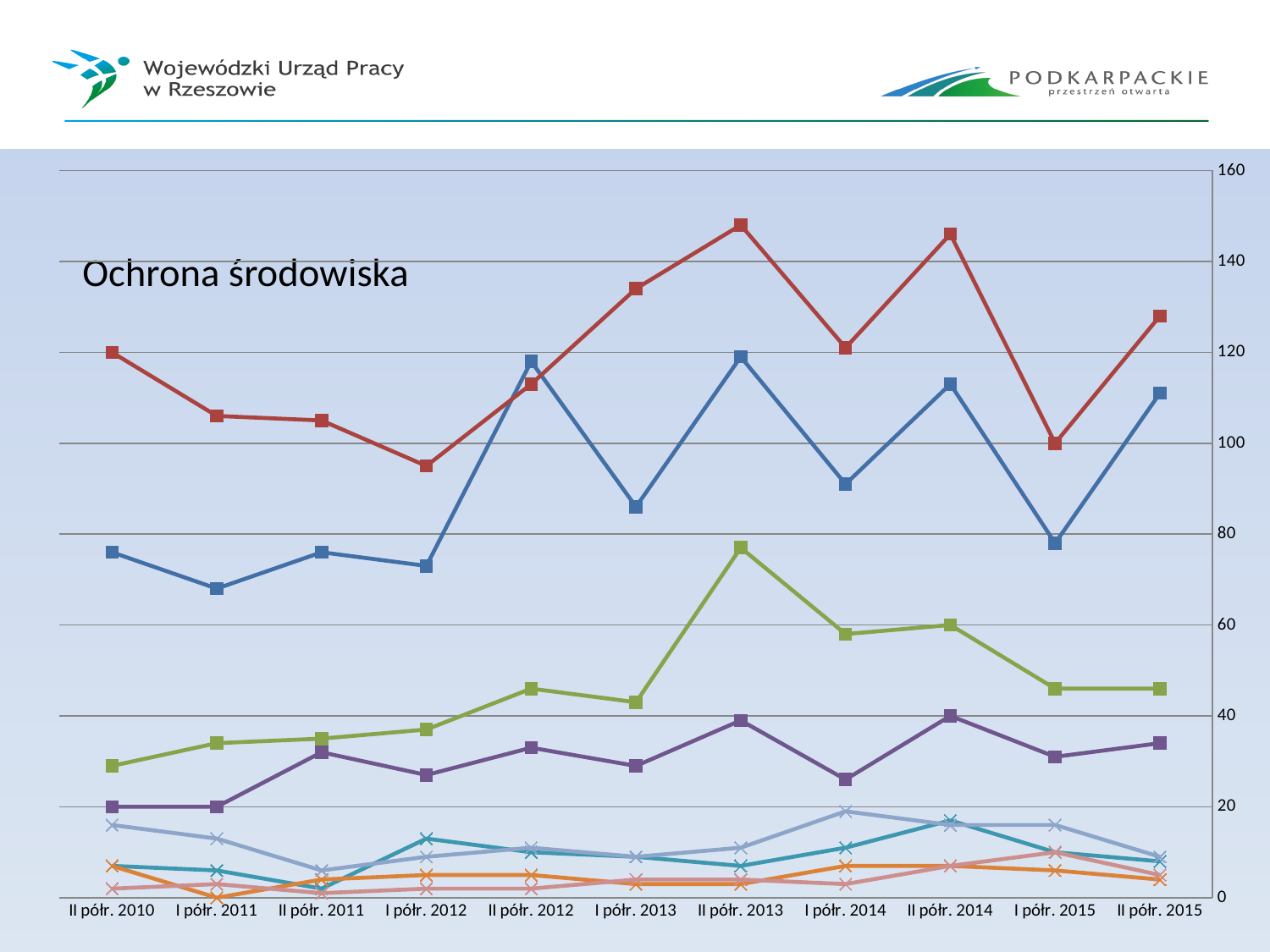
What kind of chart is shown on the slide? line chart What is the highest value shown on the y axis of the chart? 160 Is the value of the red series at I półr. 2012 greater or less than 100? less In which period does the blue series reach its lowest value? I półr. 2011 Is the value of the blue series at I półr. 2013 greater or less than 100? less In which period does the green series reach its highest value? II półr. 2013 How many periods are shown along the x axis of the chart? 11 Is the value of the green series at II półr. 2013 greater or less than 60? greater What is the title of the chart? Ochrona środowiska At I półr. 2013, which is larger: the red series or the blue series? the red series Does the red series rise or fall from II półr. 2010 to I półr. 2012? fall